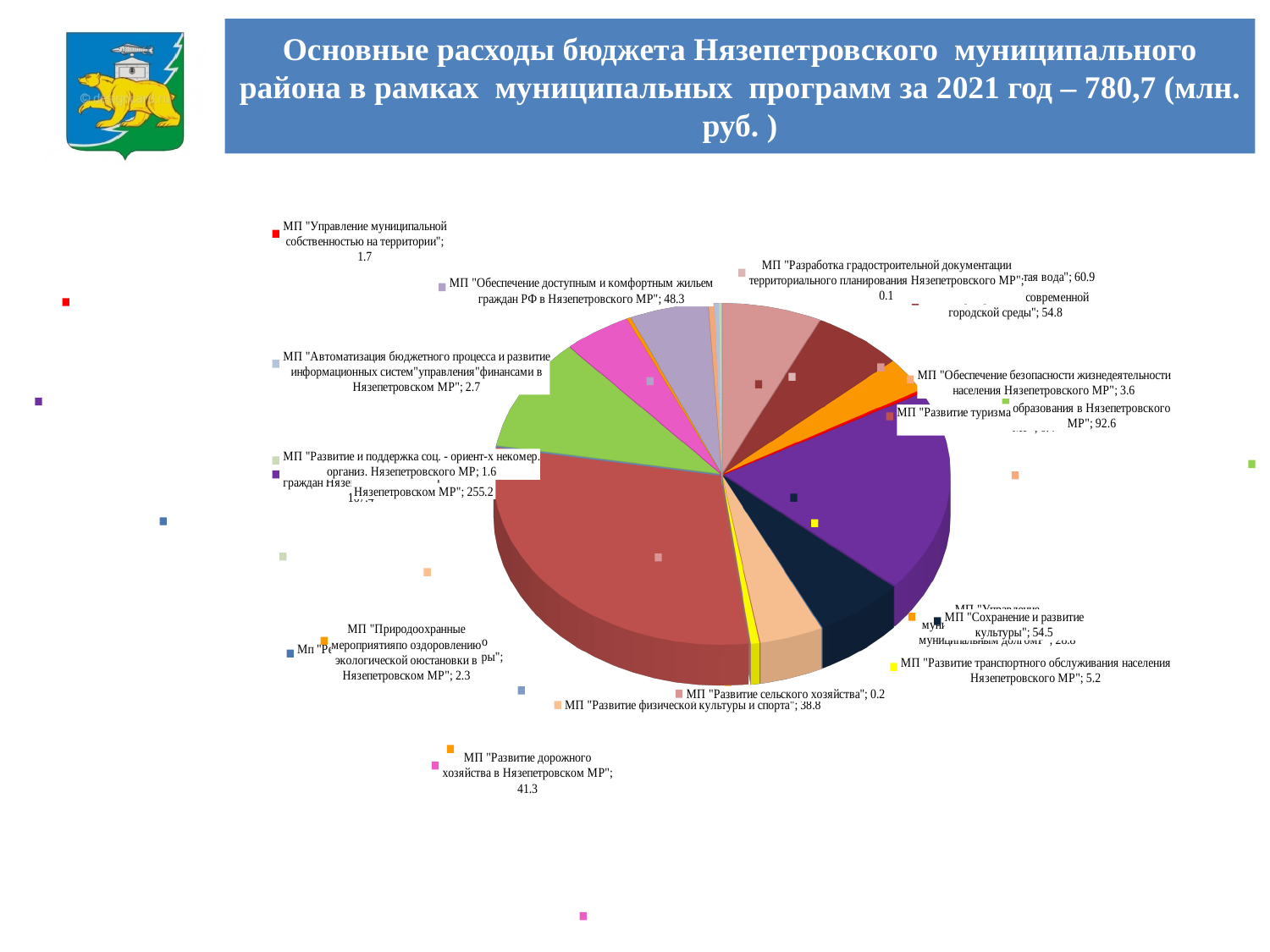
Which is larger: МП "Развитие дорожного хозяйства в Нязепетровском МР" or МП "Развитие физической культуры и спорта"? МП "Развитие дорожного хозяйства в Нязепетровском МР" What kind of chart is shown on the slide? pie chart What is the value for МП "Развитие дорожного хозяйства в Нязепетровском МР"? 41.3 What is the difference between МП "Сохранение и развитие культуры" and МП "Обеспечение доступным и комфортным жильем граждан РФ в Нязепетровском МР"? 6.2 According to the slide title, what is the total of the main budget expenditures within municipal programs for 2021? 780,7 (млн. руб.) What is the value for МП "Развитие физической культуры и спорта"? 38.8 What is the value for МП "Развитие транспортного обслуживания населения Нязепетровского МР"? 5.2 What is the value for МП "Обеспечение доступным и комфортным жильем граждан РФ в Нязепетровском МР"? 48.3 What is the value for МП "Сохранение и развитие культуры"? 54.5 What is the difference between МП "Развитие дорожного хозяйства в Нязепетровском МР" and МП "Развитие физической культуры и спорта"? 2.5 What is the value for МП "Развитие сельского хозяйства"? 0.2 What is the value for МП "Обеспечение безопасности жизнедеятельности населения Нязепетровского МР"? 3.6